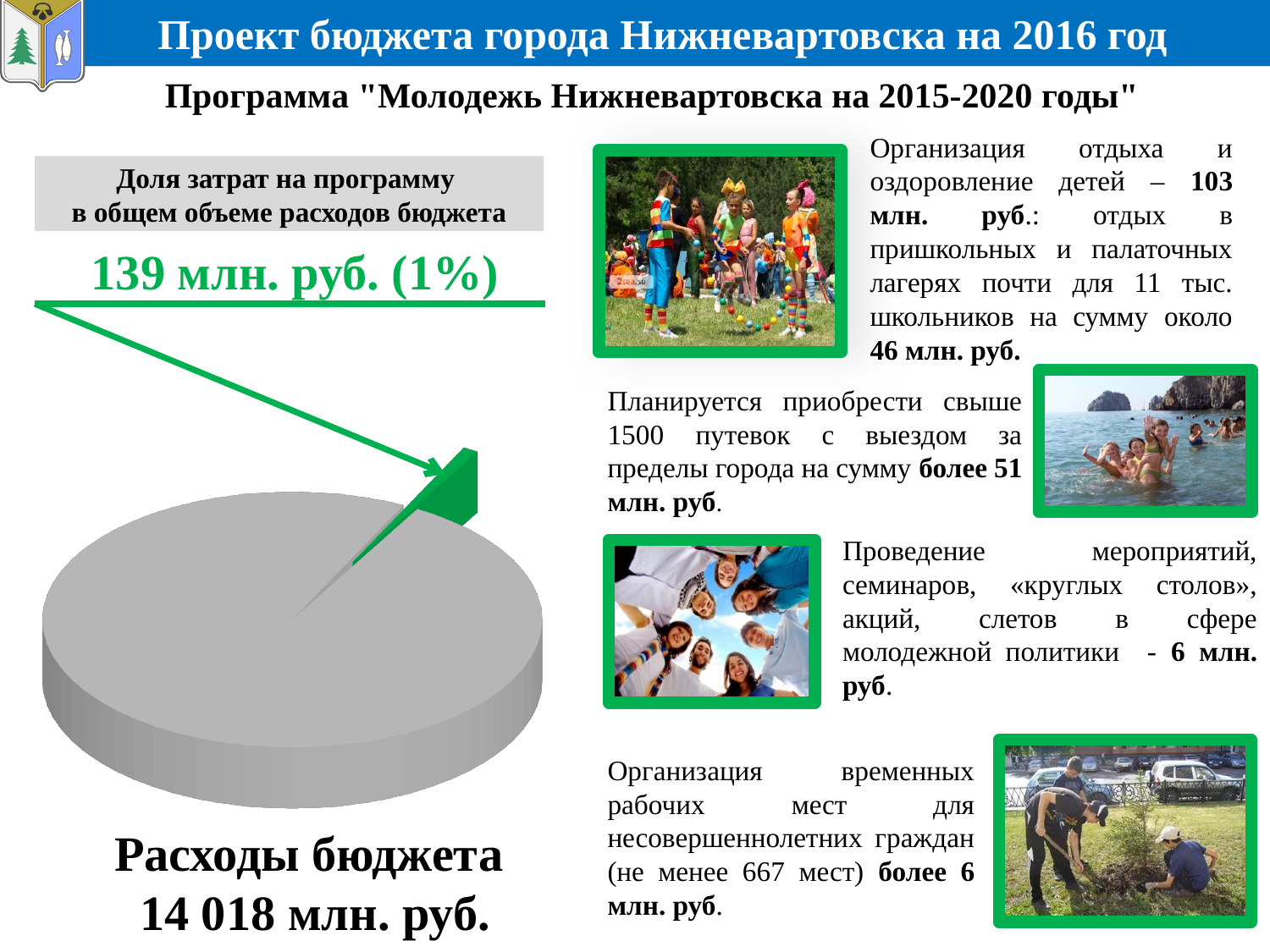
What total budget expenditure figure is printed below the pie chart? 14 018 млн. руб. Is the programme's share of budget expenditures shown in the pie chart greater or less than 10%? less What colour is the slice representing the programme costs in the pie chart? green Which slice of the pie chart is the smallest? programme costs (139 млн. руб.) What share of total budget expenditures do the costs of the programme "Молодежь Нижневартовска на 2015-2020 годы" represent, according to the pie chart? 1% Which is larger in the pie chart: the slice for programme costs or the slice for the rest of the budget expenditures? the rest of the budget expenditures How many slices does the pie chart have? 2 What is the title shown above the pie chart? Доля затрат на программу в общем объеме расходов бюджета What kind of chart is shown on the left of the slide? pie chart What is the amount of spending on the programme shown for the small green slice of the pie chart? 139 млн. руб.